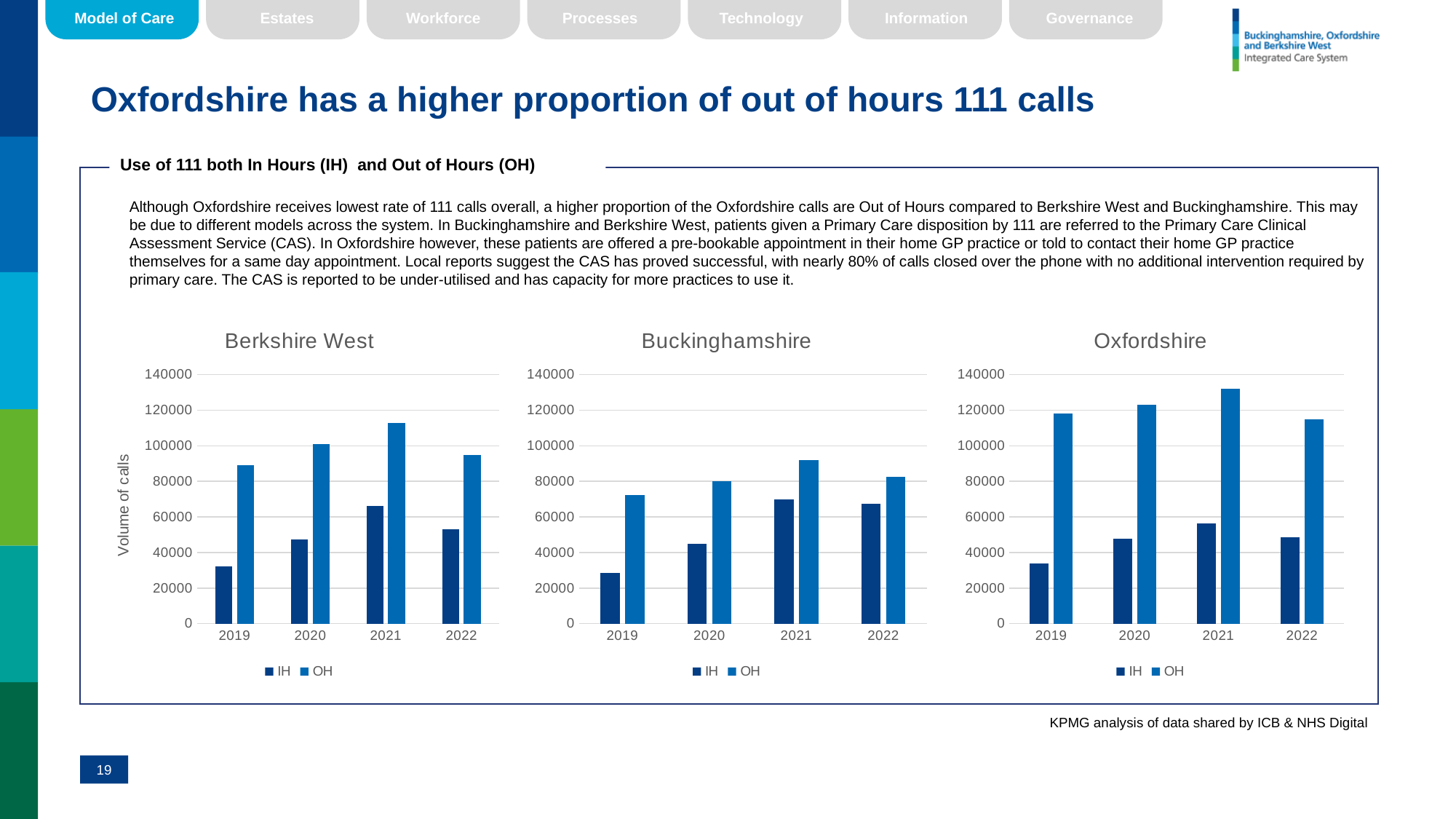
In the Buckinghamshire chart, is the IH value for 2019 greater or less than 40000? less In the Oxfordshire chart, do the IH values rise or fall from 2019 to 2021? rise What kind of chart is the Berkshire West chart? Bar chart What is the y-axis label on the Berkshire West chart? Volume of calls In the Berkshire West chart, which year has the highest IH value? 2021 How many years are shown on the x axis of the Oxfordshire chart? 4 In the Buckinghamshire chart, which year has the lowest IH value? 2019 In the Oxfordshire chart, is the OH value for 2021 greater or less than 120000? greater How many series does the legend of the Buckinghamshire chart list? 2 In the Oxfordshire chart, which year has the highest OH value? 2021 In the Berkshire West chart, which is larger in 2020, IH or OH? OH In the Berkshire West chart, is the OH value for 2021 greater or less than 100000? greater